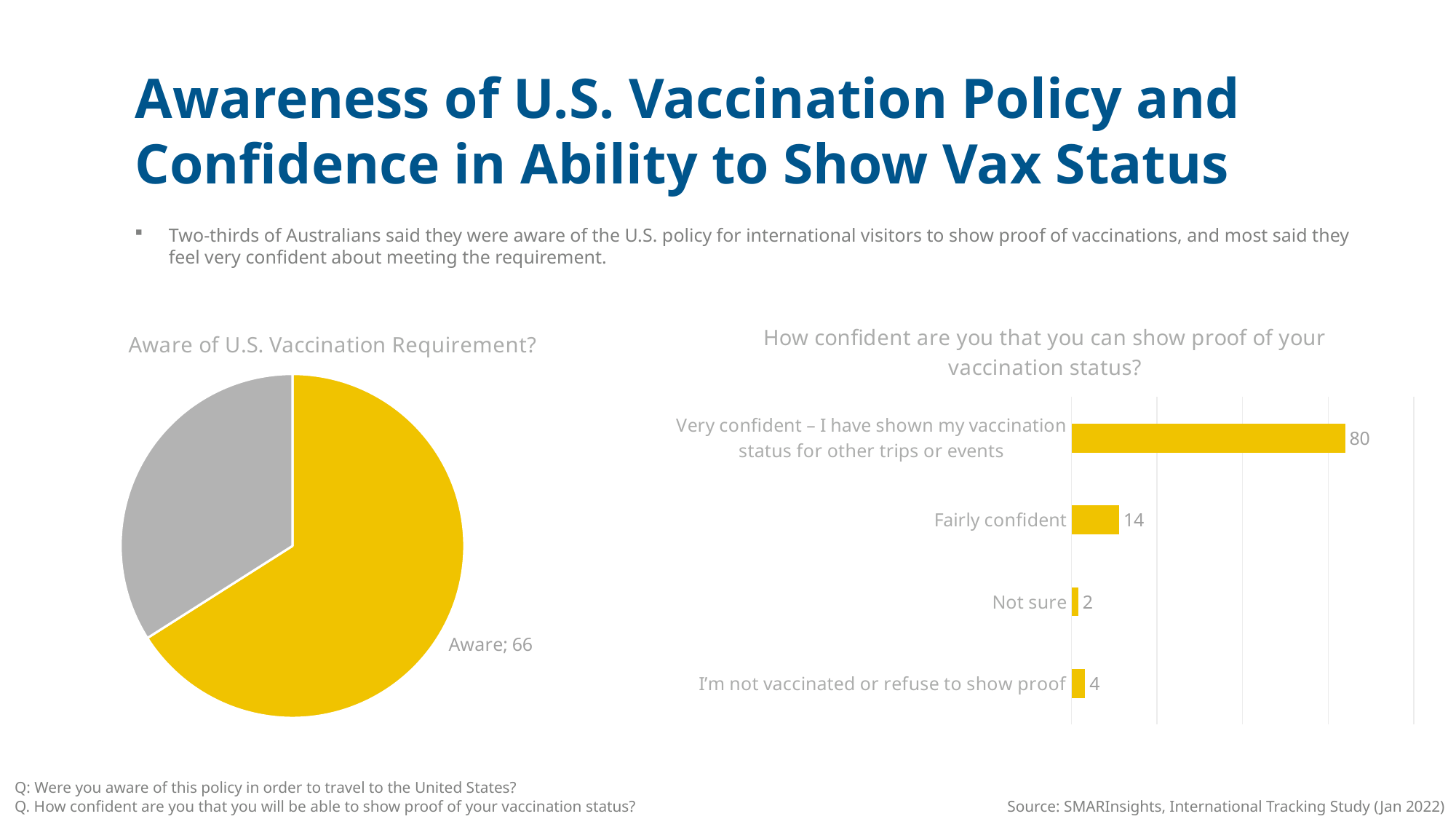
In the 'How confident are you that you can show proof of your vaccination status?' chart, which category has the highest value? Very confident – I have shown my vaccination status for other trips or events How many categories are shown in the 'How confident are you that you can show proof of your vaccination status?' chart? 4 In the 'How confident are you that you can show proof of your vaccination status?' chart, what is the value for 'Not sure'? 2 In the 'How confident are you that you can show proof of your vaccination status?' chart, what is the value for 'Fairly confident'? 14 In the 'How confident are you that you can show proof of your vaccination status?' chart, what is the value for 'I'm not vaccinated or refuse to show proof'? 4 In the 'Aware of U.S. Vaccination Requirement?' chart, what value is shown for the 'Aware' slice? 66 In the 'How confident are you that you can show proof of your vaccination status?' chart, what is the difference between the 'Very confident' value and the 'Fairly confident' value? 66 In the 'How confident are you that you can show proof of your vaccination status?' chart, what is the value for 'Very confident – I have shown my vaccination status for other trips or events'? 80 What kind of chart is 'Aware of U.S. Vaccination Requirement?'? pie chart In the 'How confident are you that you can show proof of your vaccination status?' chart, which category has the lowest value? Not sure In the 'How confident are you that you can show proof of your vaccination status?' chart, which is larger: 'Not sure' or 'I'm not vaccinated or refuse to show proof'? I'm not vaccinated or refuse to show proof What kind of chart is 'How confident are you that you can show proof of your vaccination status?'? bar chart